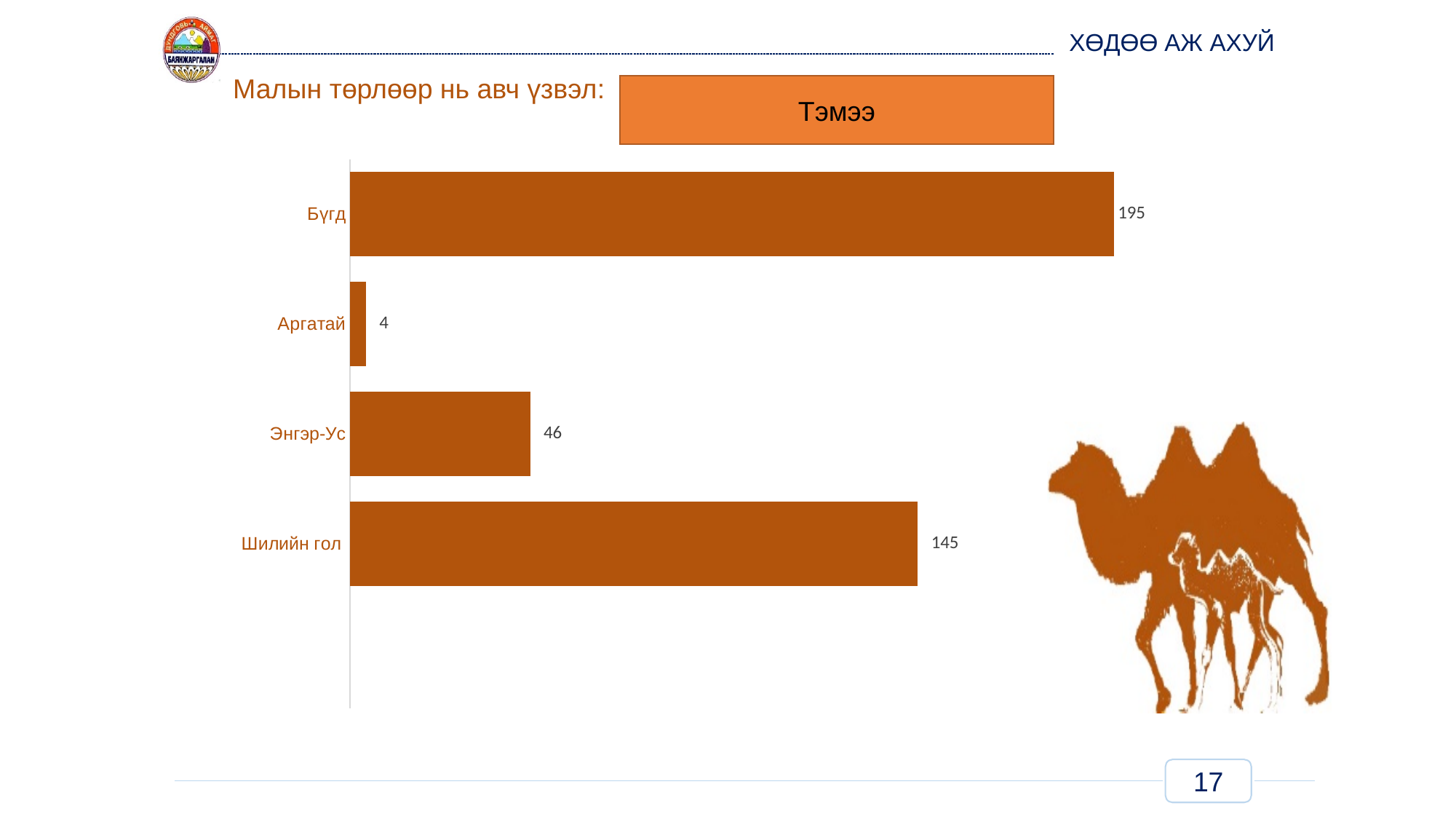
What is the value for Бүгд? 195 How many categories are shown in the chart? 4 What is the difference between the values for Шилийн гол and Энгэр-Ус? 99 What is the value for Энгэр-Ус? 46 What kind of chart is shown on the slide? Bar chart Which category has the lowest value? Аргатай What is the difference between the values for Бүгд and Шилийн гол? 50 What is the value for Аргатай? 4 What is the title shown in the orange box above the chart? Тэмээ What is the value for Шилийн гол? 145 Which is larger, the value for Энгэр-Ус or the value for Аргатай? Энгэр-Ус Which category has the highest value? Бүгд